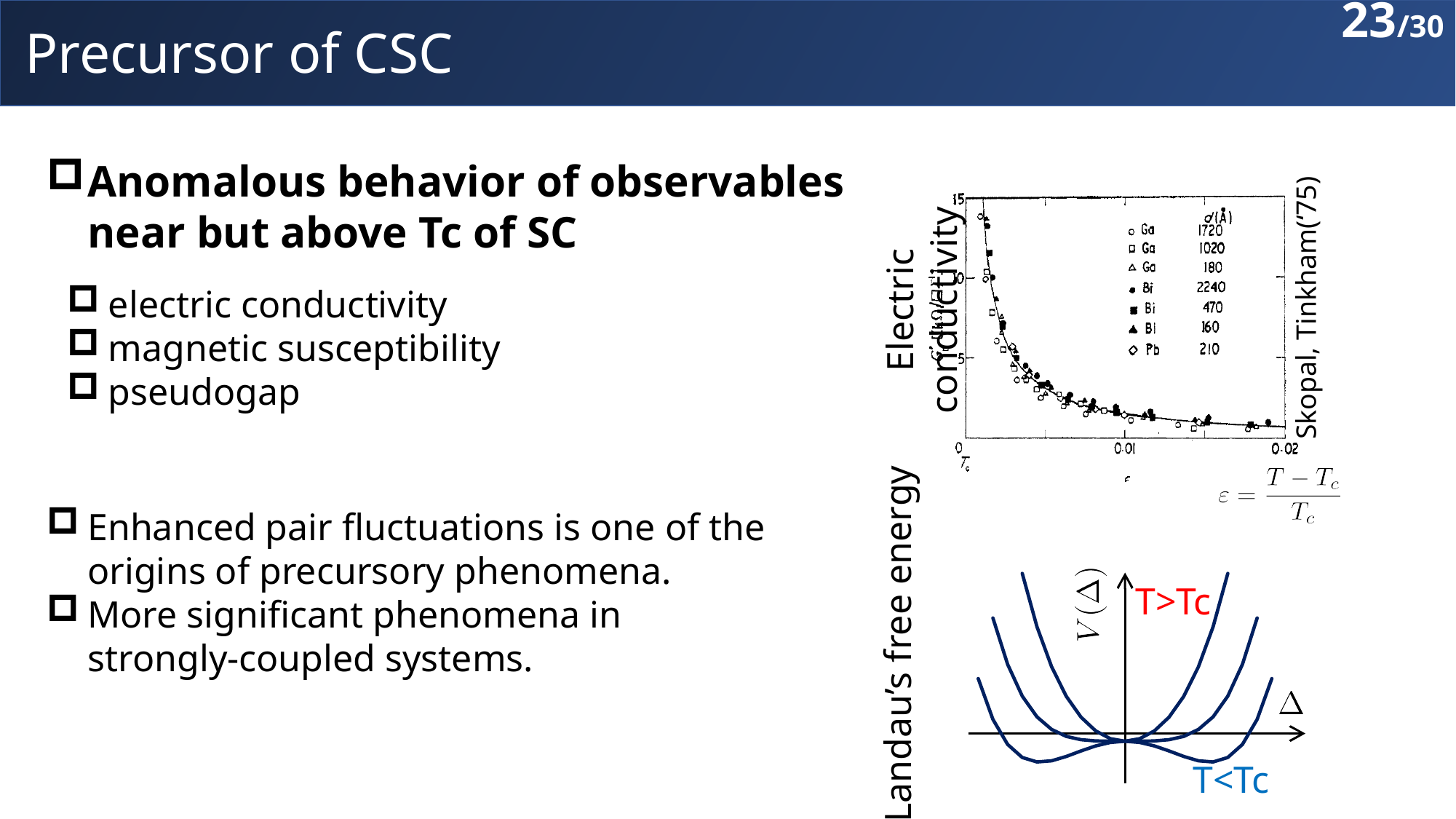
In the Landau's free energy chart at the bottom right, what label is written on the vertical axis? V(Δ) In the electric conductivity chart legend, what d(Å) value is listed for Pb? 210 In the electric conductivity chart legend, what is the difference between the d(Å) values of Ga 1720 and Ga 1020? 700 In the electric conductivity chart, do the plotted values rise or fall as ε increases along the x axis? fall In the electric conductivity chart legend, which entry has the largest d(Å) value? Bi 2240 What kind of chart is the electric conductivity plot (Skopal, Tinkham '75)? scatter plot with a fitted curve In the Landau's free energy chart, which temperature label is shown in blue? T<Tc In the electric conductivity chart, is the plotted value at ε = 0.01 greater or less than 5? less In the electric conductivity chart, what is the largest tick value shown on the x axis (ε)? 0.02 In the electric conductivity chart, how many entries does the legend list? 7 In the electric conductivity chart legend, which entry has the smallest d(Å) value? Bi 160 In the electric conductivity chart, what is the largest tick value shown on the y axis? 15